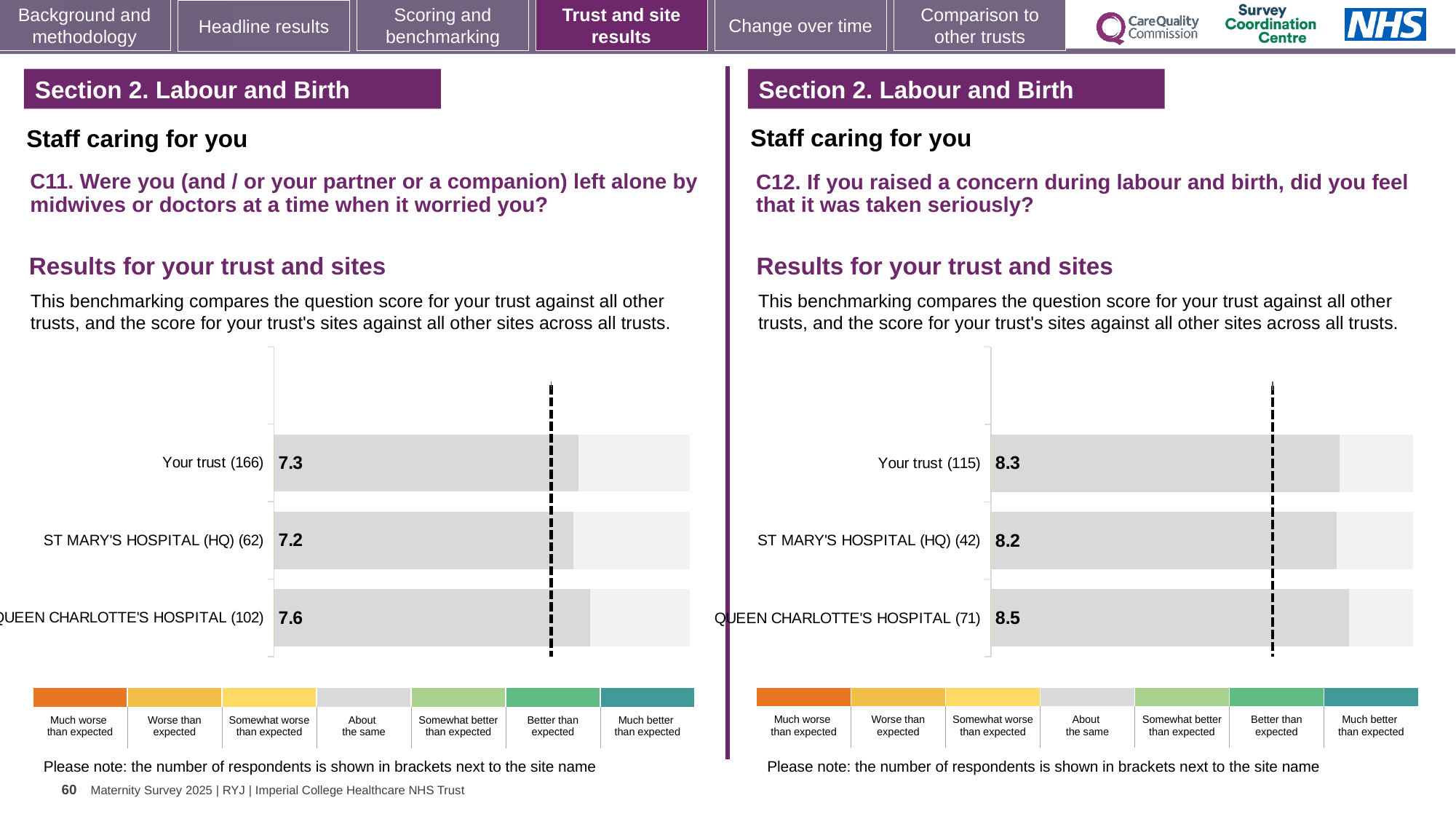
In the C11 chart on the left, what is the difference between the scores for QUEEN CHARLOTTE'S HOSPITAL and ST MARY'S HOSPITAL (HQ)? 0.4 In the C12 chart on the right, which site or trust has the highest score? QUEEN CHARLOTTE'S HOSPITAL In the C11 chart on the left, how many respondents are shown for ST MARY'S HOSPITAL (HQ)? 62 Which is larger: the score for Your trust in the C11 chart or the score for Your trust in the C12 chart? C12 (8.3) In the C12 chart on the right, what is the score for ST MARY'S HOSPITAL (HQ)? 8.2 How many bars are plotted in the C11 chart on the left? 3 In the C12 chart on the right, what is the difference between the scores for QUEEN CHARLOTTE'S HOSPITAL and Your trust? 0.2 In the C12 chart on the right, how many respondents are shown for Your trust? 115 In the C11 chart on the left, what is the score for QUEEN CHARLOTTE'S HOSPITAL? 7.6 In the C11 chart on the left, which site or trust has the lowest score? ST MARY'S HOSPITAL (HQ) In the C11 chart on the left, what is the score for Your trust? 7.3 What type of chart is used in the C12 chart on the right? Bar chart